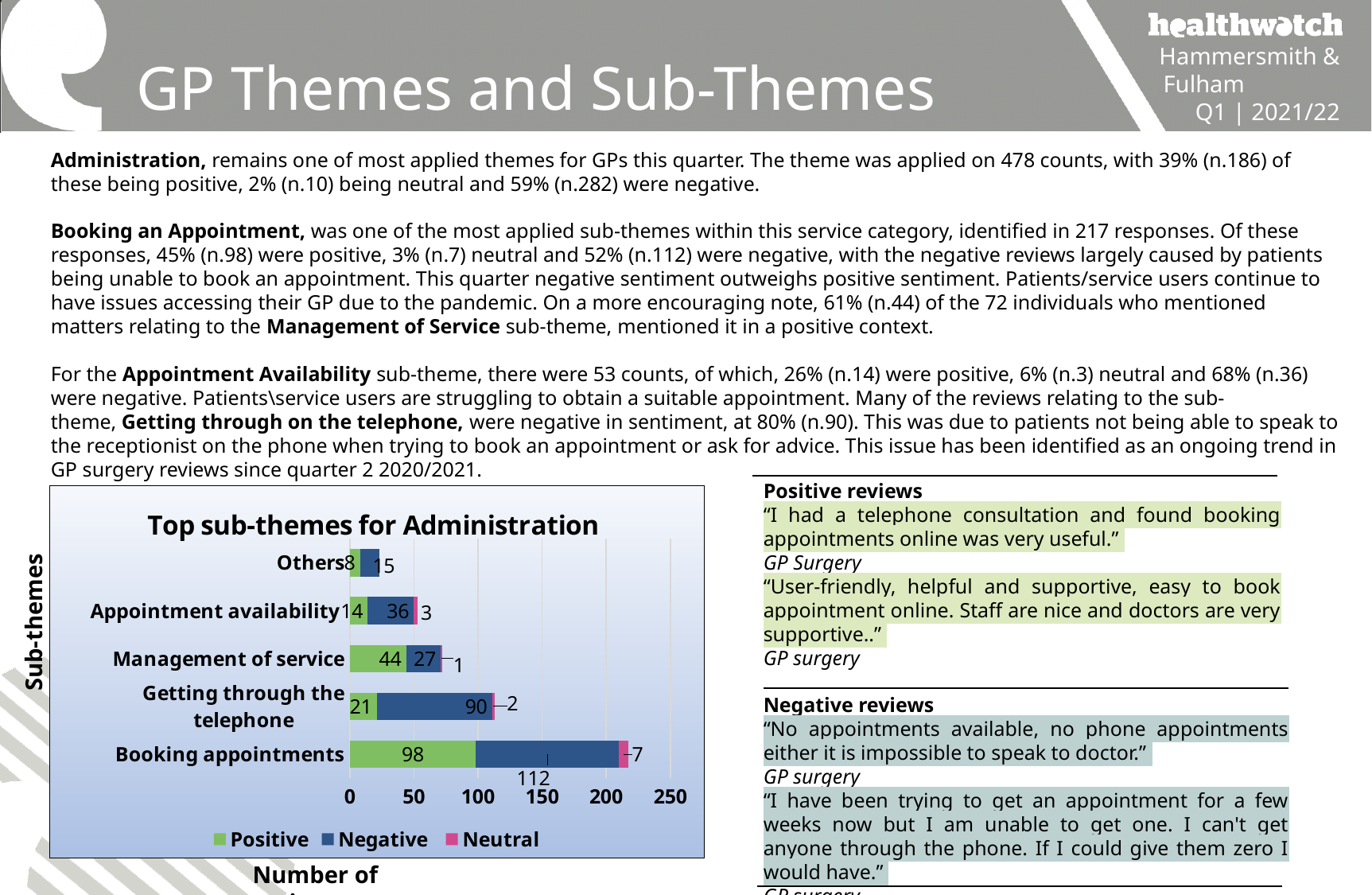
What is the Neutral value for Appointment availability? 3 What is the title of the chart? Top sub-themes for Administration What type of chart is shown on the slide? Stacked bar chart What is the difference between the Negative and Positive values for Getting through the telephone? 69 What is the Positive value for Booking appointments? 98 Which sub-theme has the shortest total bar? Others How many series does the chart legend list? 3 Which sub-theme has the longest total bar? Booking appointments What is the Negative value for Getting through the telephone? 90 What is the total of the stacked bar for Appointment availability? 53 What is the Positive value for Management of service? 44 How many sub-theme categories are plotted in the chart? 5